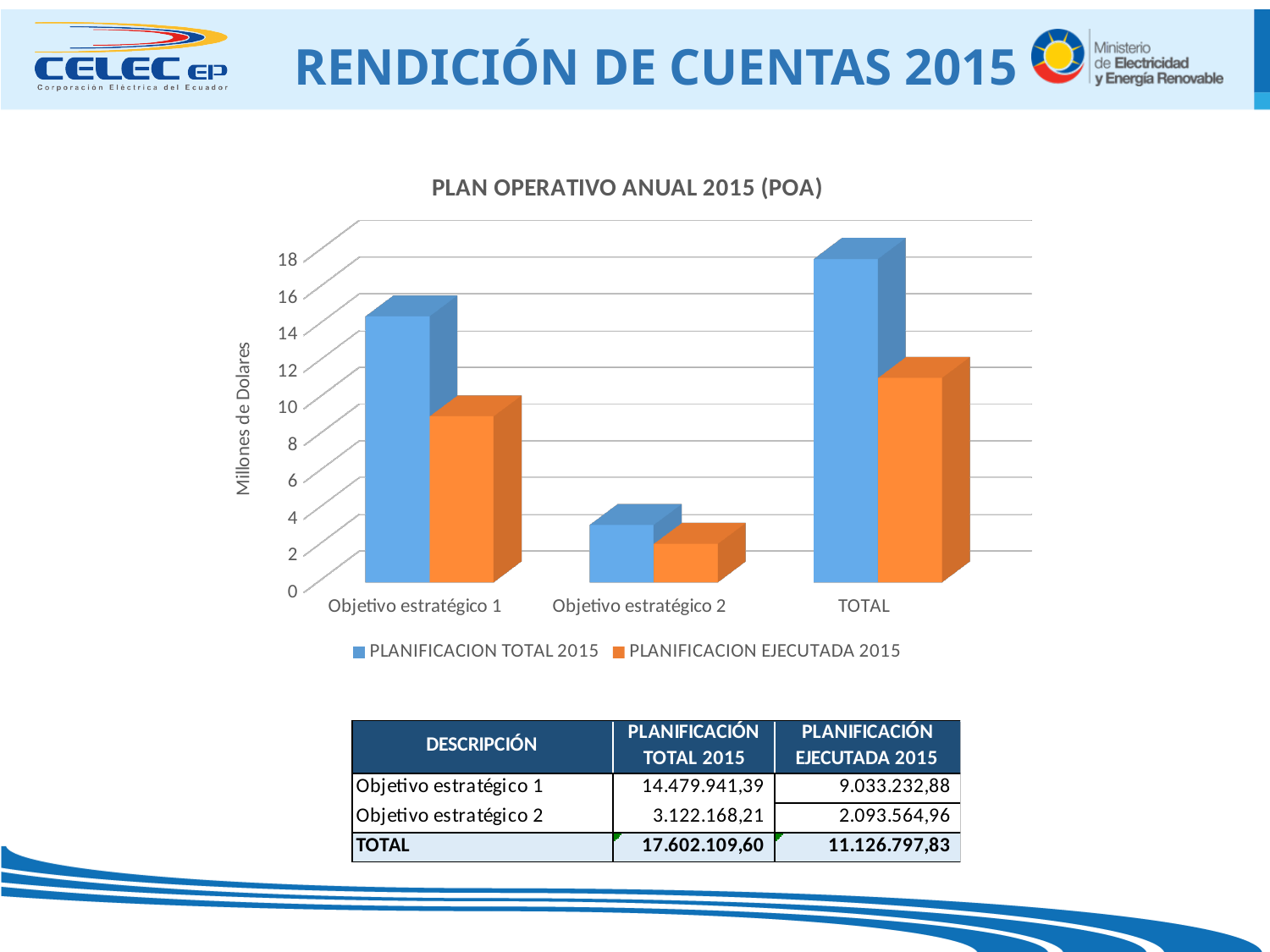
How many series does the chart legend list? 2 What is the PLANIFICACIÓN TOTAL 2015 value for Objetivo estratégico 1? 14.479.941,39 What is the title of the chart? PLAN OPERATIVO ANUAL 2015 (POA) Which category has the tallest PLANIFICACION TOTAL 2015 bar? TOTAL Which category has the shortest PLANIFICACION EJECUTADA 2015 bar? Objetivo estratégico 2 Which is larger for Objetivo estratégico 2: PLANIFICACION TOTAL 2015 or PLANIFICACION EJECUTADA 2015? PLANIFICACION TOTAL 2015 What is the difference between PLANIFICACIÓN TOTAL 2015 and PLANIFICACIÓN EJECUTADA 2015 for Objetivo estratégico 1? 5.446.708,51 What type of chart is shown on the slide? bar chart How many categories are shown on the x axis of the chart? 3 What is the PLANIFICACIÓN EJECUTADA 2015 value for Objetivo estratégico 2? 2.093.564,96 What is the PLANIFICACIÓN EJECUTADA 2015 value for TOTAL? 11.126.797,83 Is the PLANIFICACION TOTAL 2015 bar for Objetivo estratégico 1 greater or less than 12 million dollars? greater